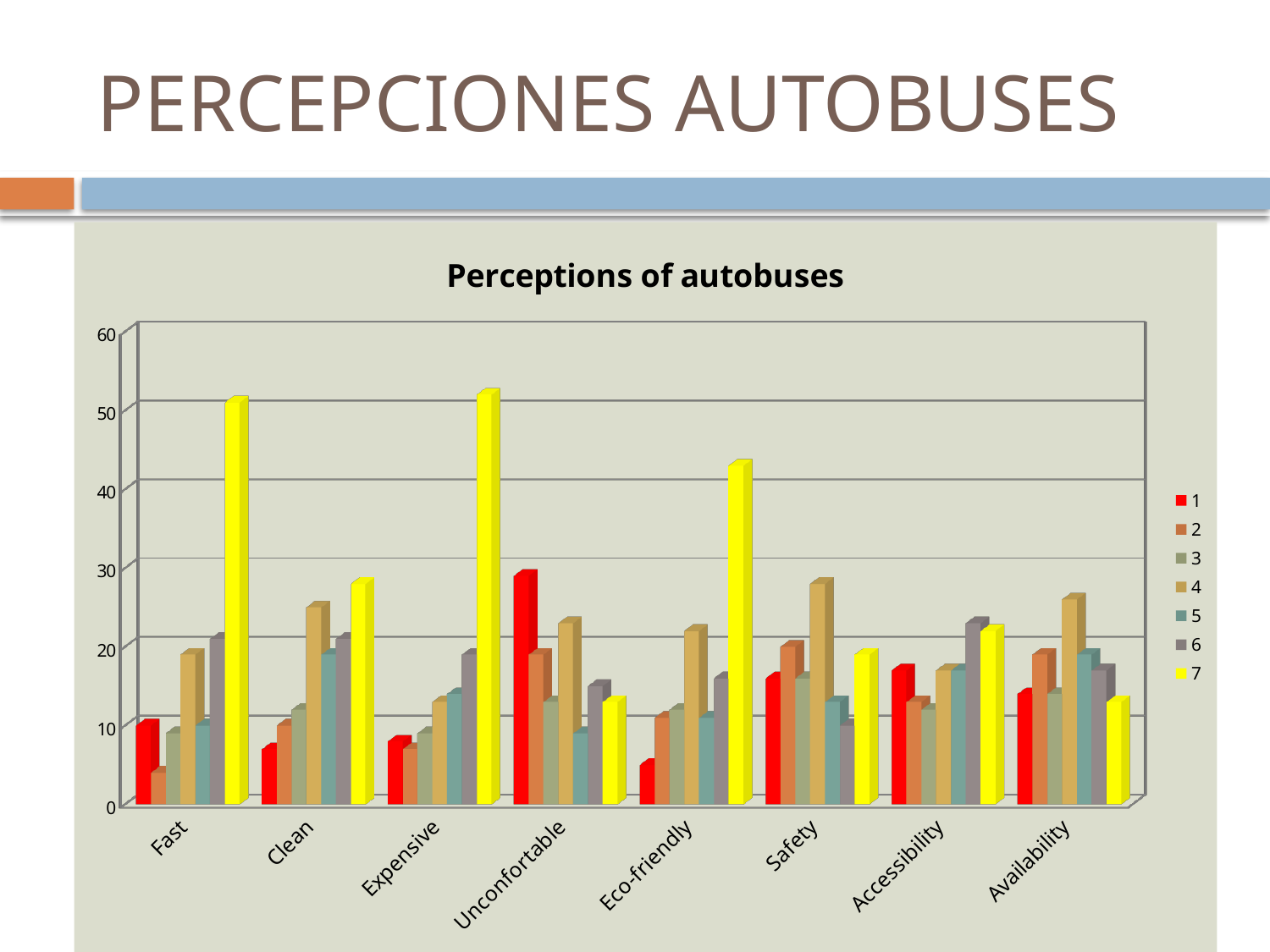
Is the value of series 7 for Eco-friendly greater or less than 30? greater Which series has the highest bar for the Fast category? 7 Is the value of series 7 for Fast greater or less than 40? greater Which is larger: the value of series 7 for Fast or the value of series 7 for Eco-friendly? Fast Which is larger: the value of series 1 for Unconfortable or the value of series 1 for Eco-friendly? Unconfortable What kind of chart is shown on the slide? bar chart Is the value of series 1 for Unconfortable greater or less than 20? greater Which series has the lowest bar for the Fast category? 2 How many series does the chart's legend list? 7 How many categories are shown on the x axis of the chart? 8 What is the title of the chart? Perceptions of autobuses